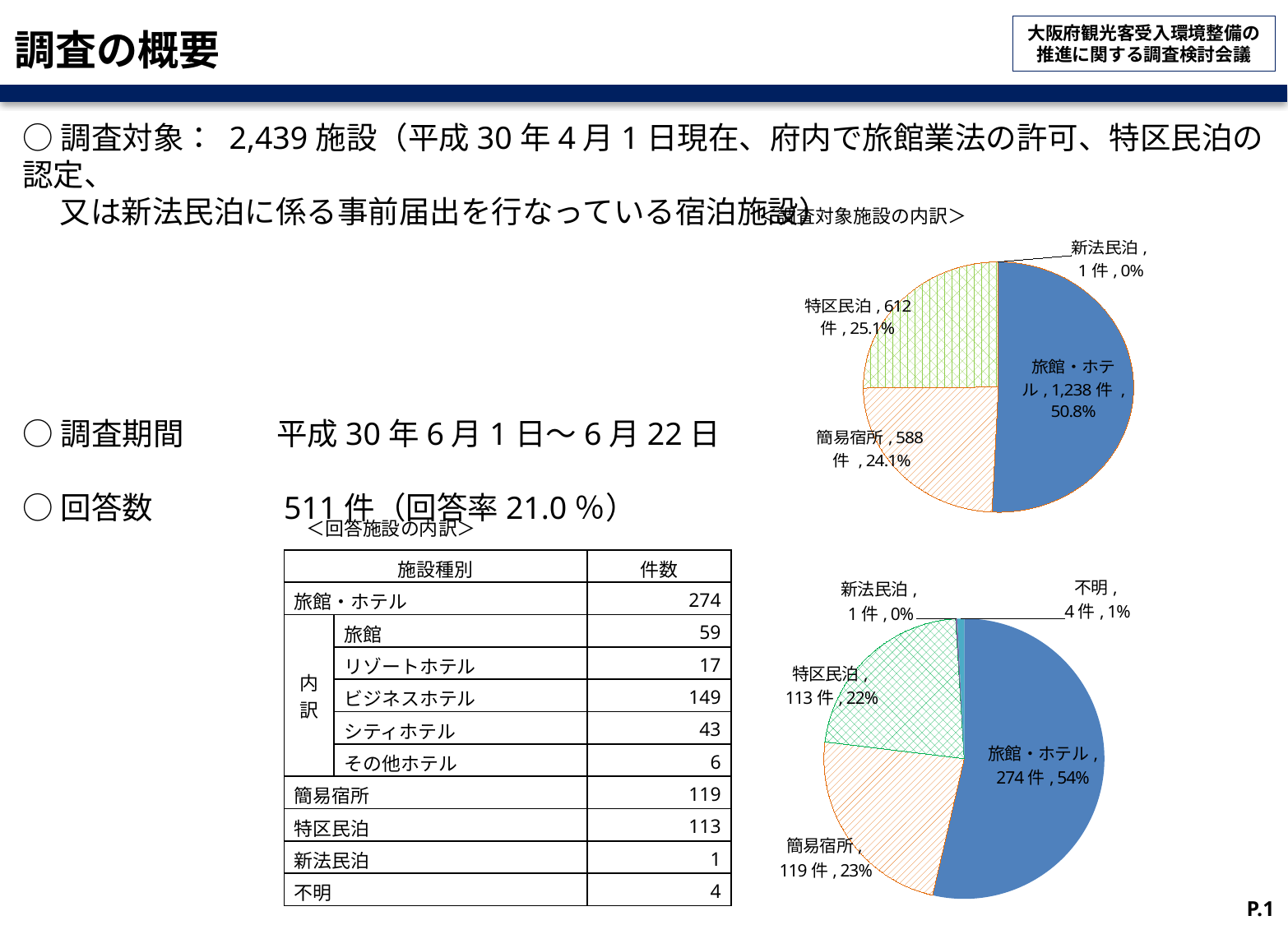
In the top pie chart (調査対象施設の内訳), which category has the largest slice? 旅館・ホテル In the bottom pie chart (回答施設の内訳), which is larger, 簡易宿所 or 特区民泊? 簡易宿所 In the top pie chart (調査対象施設の内訳), what is the difference in number of facilities between 特区民泊 and 簡易宿所? 24 件 In the top pie chart (調査対象施設の内訳), which category has the smallest slice? 新法民泊 In the bottom pie chart (回答施設の内訳), how many categories are shown? 5 In the bottom pie chart (回答施設の内訳), what share of the pie does 旅館・ホテル represent? 54% What type of chart is used for 調査対象施設の内訳 on the slide? Pie chart In the top pie chart (調査対象施設の内訳), how many facilities are in the 旅館・ホテル category? 1,238 件 In the bottom pie chart (回答施設の内訳), what is the difference in number of facilities between 旅館・ホテル and 特区民泊? 161 件 In the bottom pie chart (回答施設の内訳), how many facilities are in the 簡易宿所 category? 119 件 In the top pie chart (調査対象施設の内訳), how many categories are shown? 4 In the top pie chart (調査対象施設の内訳), what share of the pie does 特区民泊 represent? 25.1%